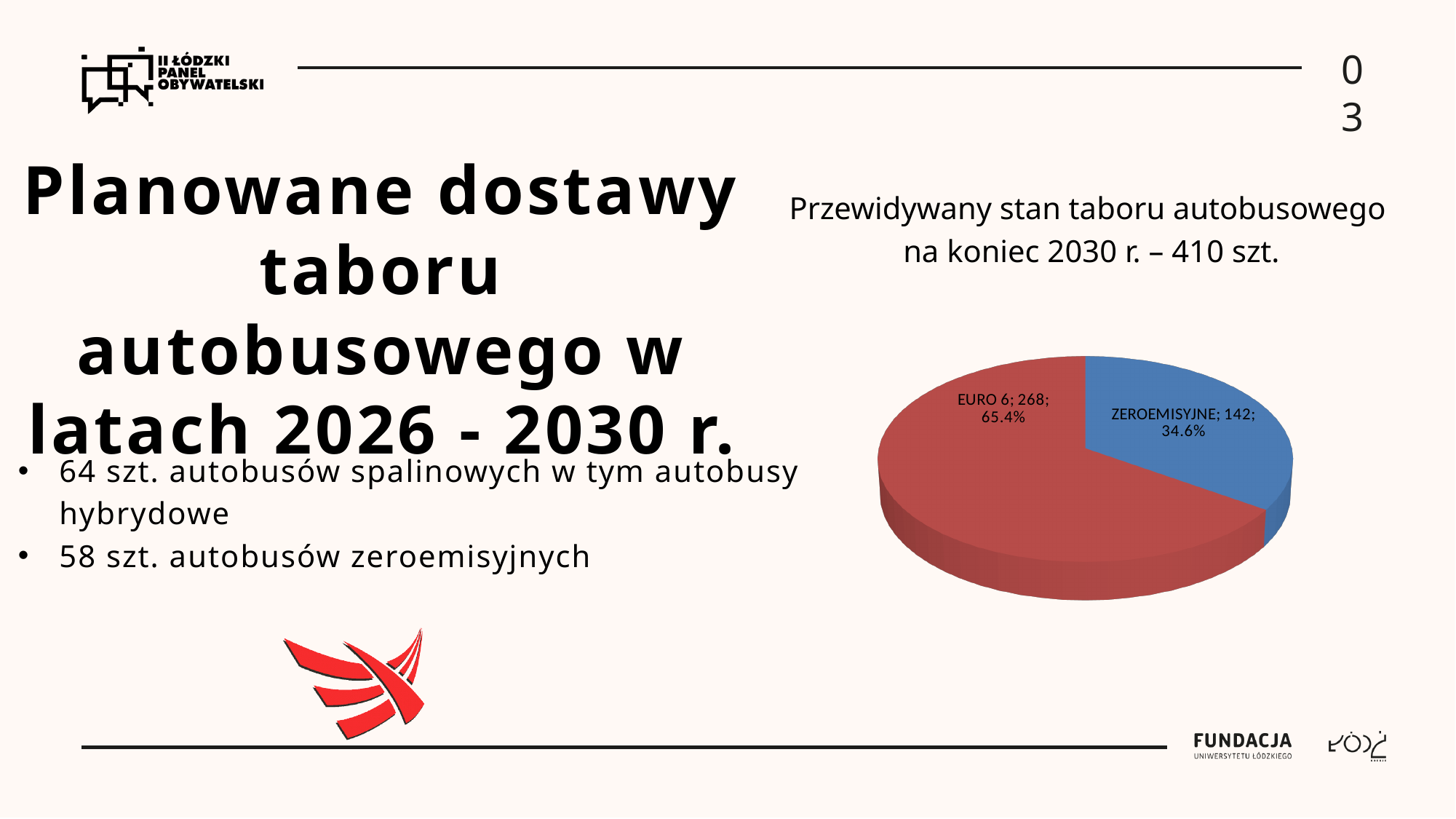
What is the difference between the EURO 6 and ZEROEMISYJNE values? 126 What is the value for EURO 6 in the pie chart? 268 Which is larger, the value for EURO 6 or for ZEROEMISYJNE? EURO 6 Which category has the smallest slice in the pie chart? ZEROEMISYJNE Which category has the largest slice in the pie chart? EURO 6 What is the total of the two slices in the pie chart? 410 What kind of chart is shown on the slide? pie chart What share of the pie does the EURO 6 slice represent? 65.4% What is the value for ZEROEMISYJNE in the pie chart? 142 How many slices does the pie chart have? 2 What share of the pie does the ZEROEMISYJNE slice represent? 34.6% What colour is the ZEROEMISYJNE slice in the pie chart? blue